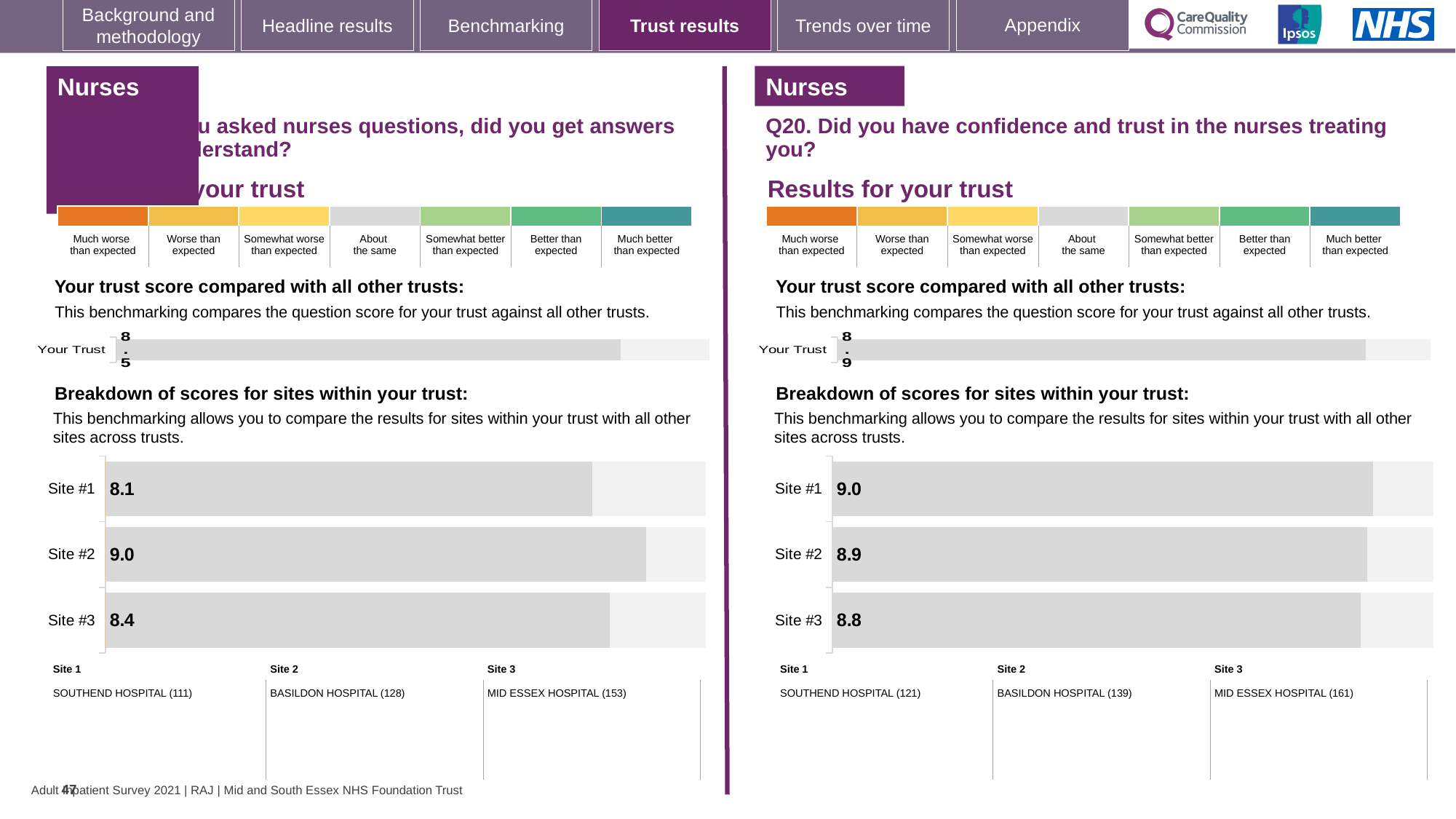
On the Q20 site breakdown chart (right-hand side), which site has the highest score? Site #1 On the left-hand site breakdown chart, what is the score for Site #1? 8.1 On the left-hand 'Your trust score compared with all other trusts' chart, what is the score for Your Trust? 8.5 On the Q20 site breakdown chart (right-hand side), what is the score for Site #3? 8.8 On the left-hand site breakdown chart, which site has the lowest score? Site #1 On the Q20 site breakdown chart (right-hand side), how many sites are plotted? 3 Is the score for Site #2 on the left-hand site breakdown chart larger or smaller than the score for Site #2 on the Q20 chart on the right? larger On the Q20 site breakdown chart (right-hand side), what is the difference between the scores for Site #1 and Site #3? 0.2 What type of chart is used for the site breakdown on the left-hand side of the slide? Bar chart On the Q20 'Your trust score compared with all other trusts' chart (right-hand side), what is the score for Your Trust? 8.9 On the left-hand site breakdown chart, which site has the highest score? Site #2 On the left-hand site breakdown chart, what is the difference between the scores for Site #2 and Site #3? 0.6